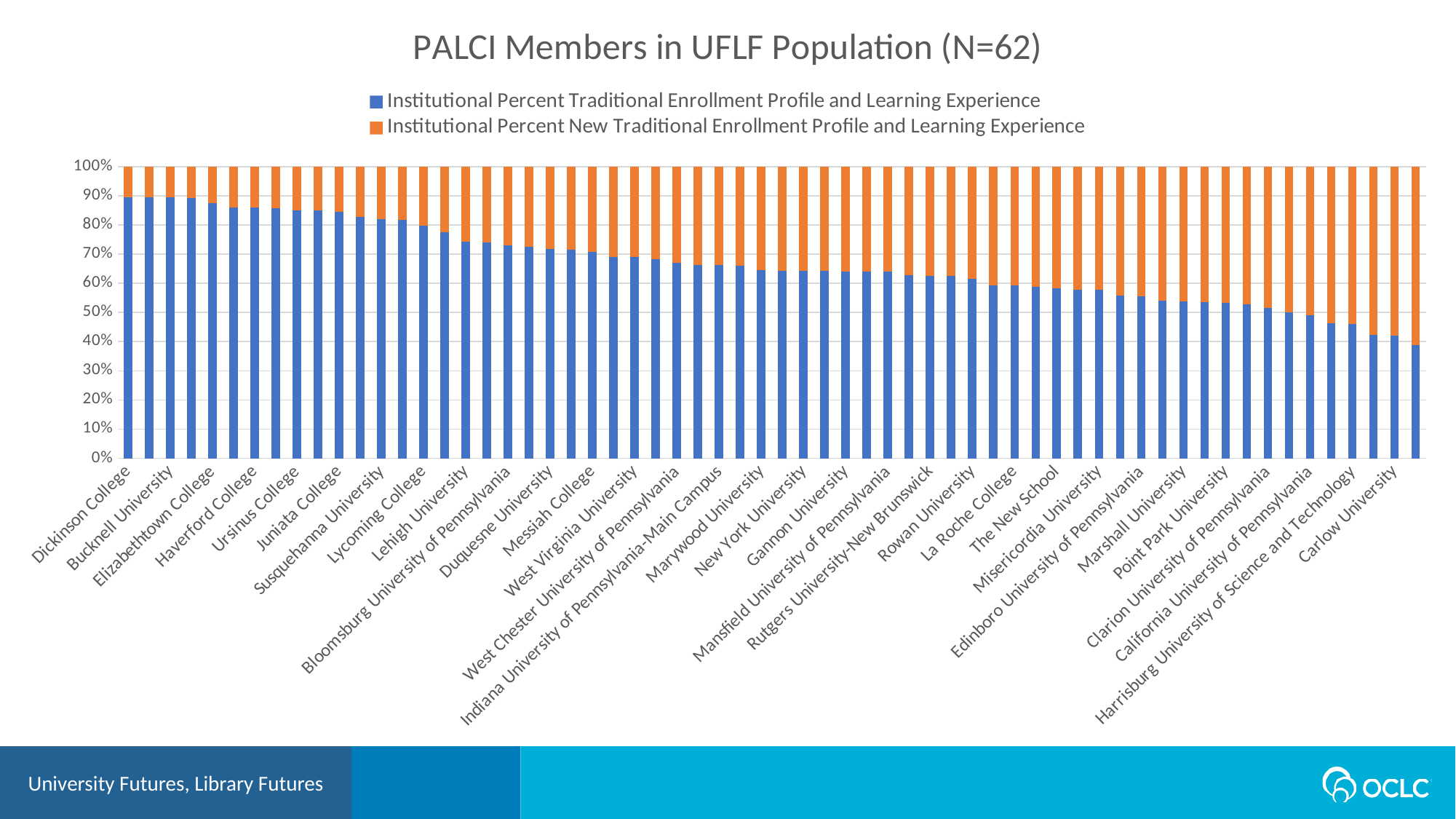
Which series is shown in orange? Institutional Percent New Traditional Enrollment Profile and Learning Experience Does the Institutional Percent Traditional Enrollment Profile and Learning Experience series rise or fall from left to right along the x axis? fall Is the Institutional Percent Traditional Enrollment Profile and Learning Experience value for Carlow University greater or less than 50%? less According to the chart title, how many PALCI members are in the UFLF population? 62 Is the Institutional Percent Traditional Enrollment Profile and Learning Experience value for Marshall University greater or less than 60%? less Is the Institutional Percent Traditional Enrollment Profile and Learning Experience value for Dickinson College greater or less than 80%? greater Which has a larger Institutional Percent Traditional Enrollment Profile and Learning Experience value, Dickinson College or Carlow University? Dickinson College What do the two stacked segments of each bar add up to? 100% How many series does the legend list? 2 What type of chart is shown on the slide? Stacked bar chart What is the title of the chart? PALCI Members in UFLF Population (N=62)